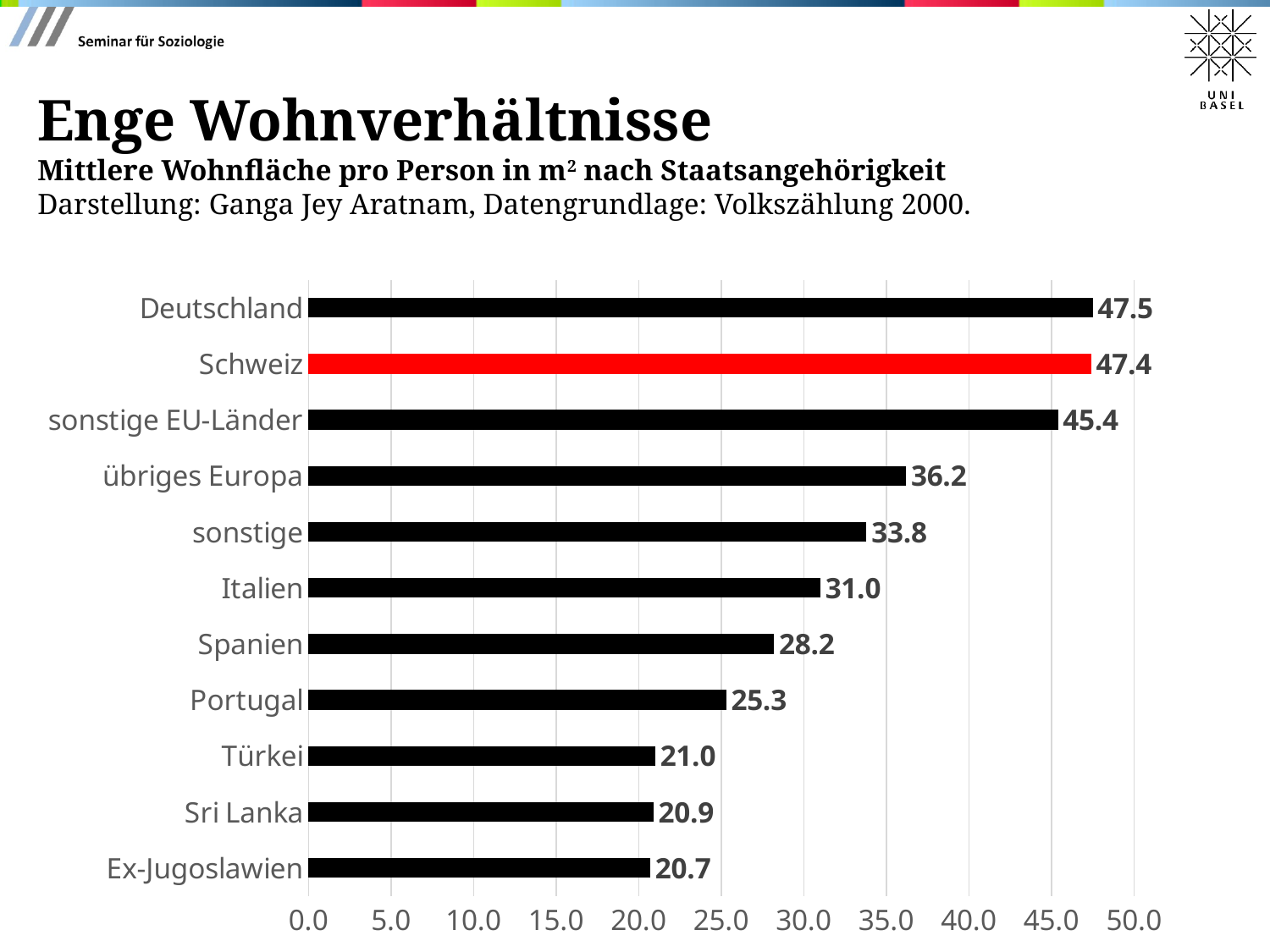
Which category has the highest value? Deutschland What is the difference between the values for übriges Europa and Spanien? 8.0 Which category has the lowest value? Ex-Jugoslawien What is the value for Schweiz? 47.4 How many categories are shown in the chart? 11 What kind of chart is shown on the slide? bar chart What is the value for Italien? 31.0 What is the value for Ex-Jugoslawien? 20.7 What is the difference between the values for Deutschland and Portugal? 22.2 Is the value for Türkei greater or less than 25.0? less Which is larger, the value for sonstige EU-Länder or the value for sonstige? sonstige EU-Länder Which bar is coloured red? Schweiz